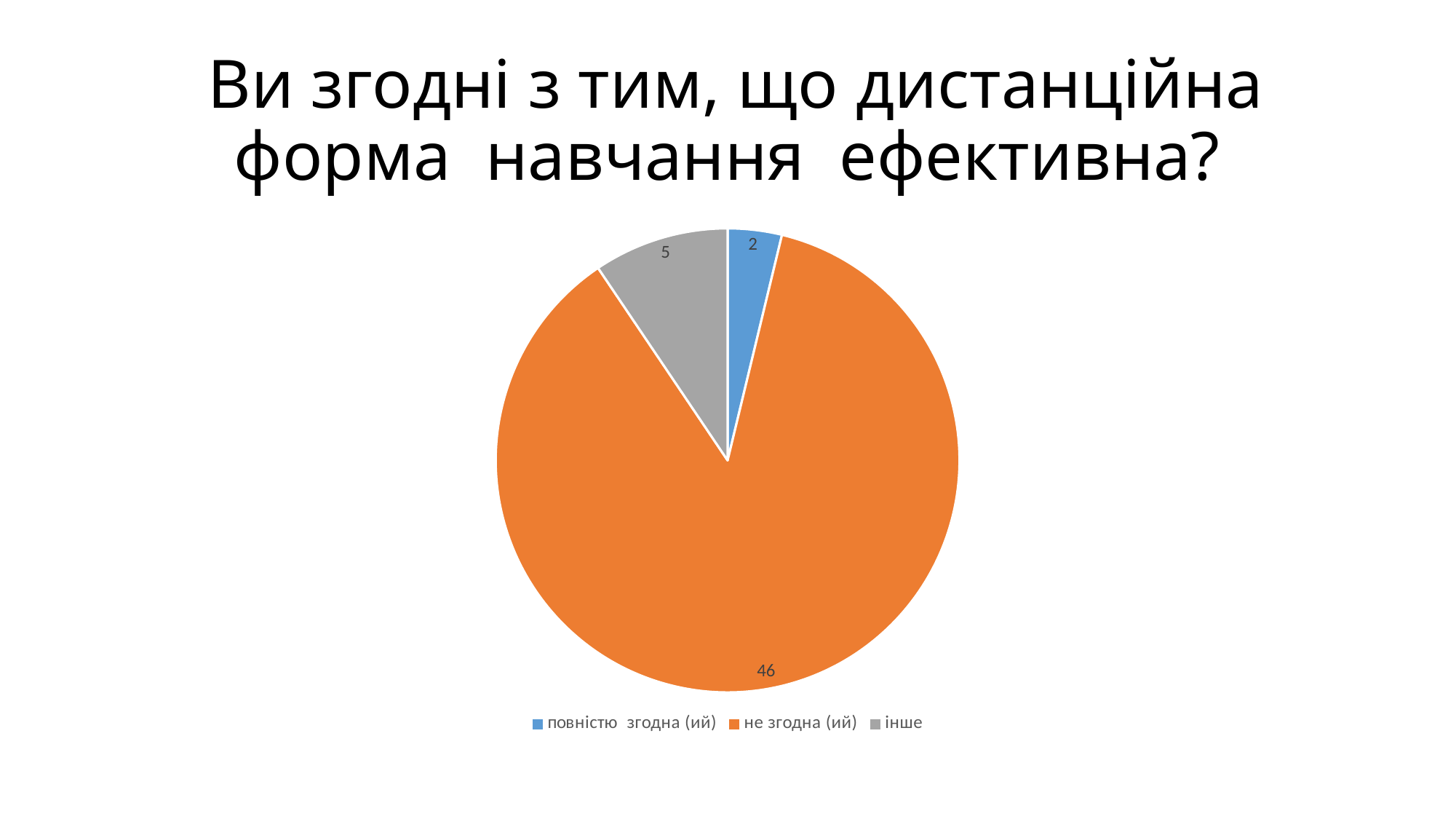
What is the value for the slice "повністю згодна (ий)"? 2 What is the total of all the values shown in the pie chart? 53 What is the difference between the values for "не згодна (ий)" and "інше"? 41 How many slices does the pie chart have? 3 What is the difference between the values for "інше" and "повністю згодна (ий)"? 3 Which is larger, the value for "інше" or the value for "повністю згодна (ий)"? інше What kind of chart is shown on the slide? pie chart What colour is the slice for "не згодна (ий)"? orange What is the value for the slice "не згодна (ий)"? 46 Which category has the largest slice of the pie? не згодна (ий) Which category has the smallest slice of the pie? повністю згодна (ий) What is the value for the slice "інше"? 5